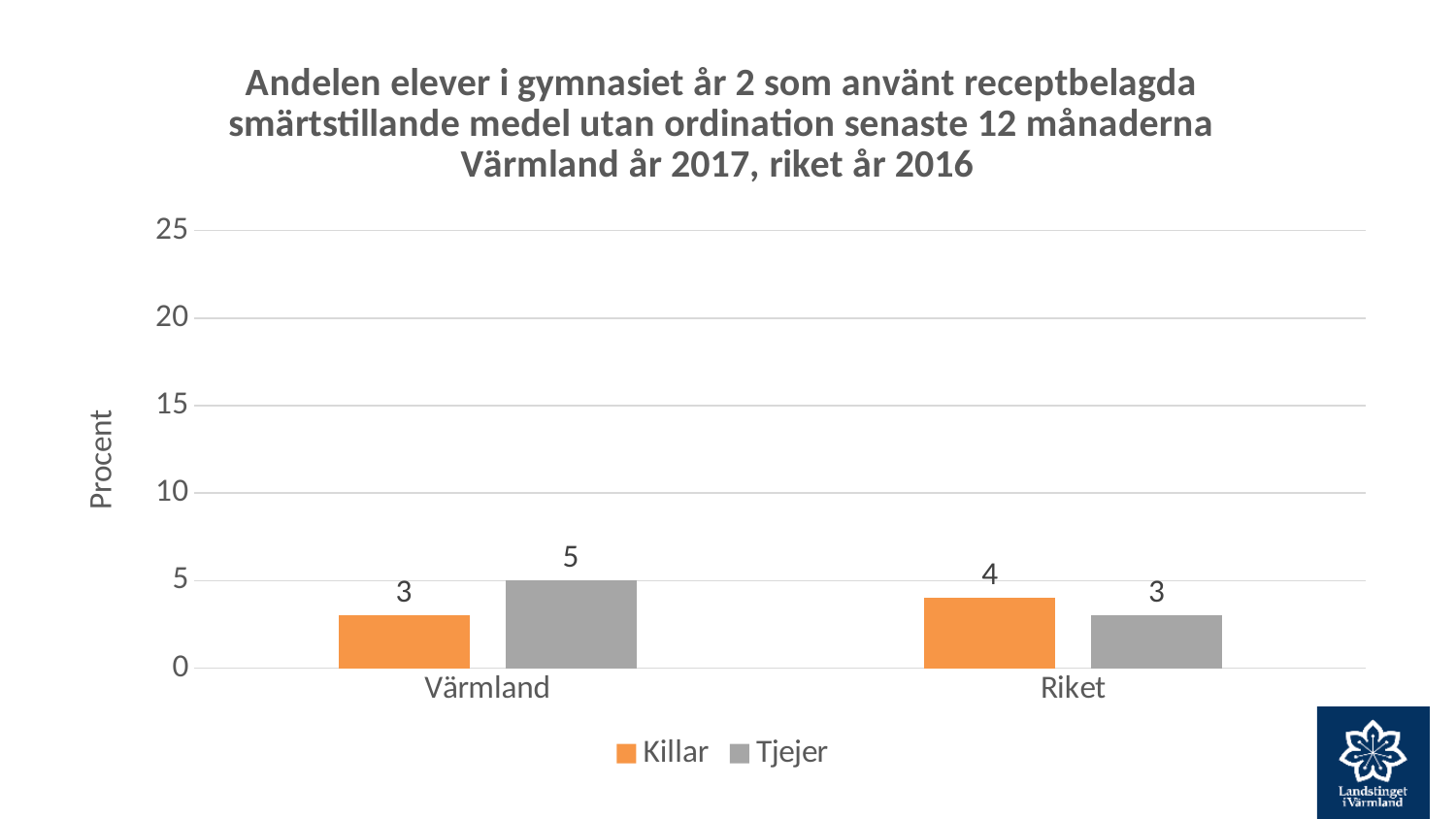
Which series has the lowest value in Riket? Tjejer Is the value for Tjejer in Värmland greater or less than 10? less What is the value for Tjejer in Riket? 3 Which is larger: Killar in Riket or Killar in Värmland? Killar in Riket How many categories are shown on the x axis? 2 What is the difference between Tjejer and Killar in Värmland? 2 What kind of chart is shown on the slide? bar chart What is the value for Killar in Riket? 4 What is the value for Killar in Värmland? 3 Which series has the highest value in Värmland? Tjejer How many series does the legend list? 2 What is the value for Tjejer in Värmland? 5